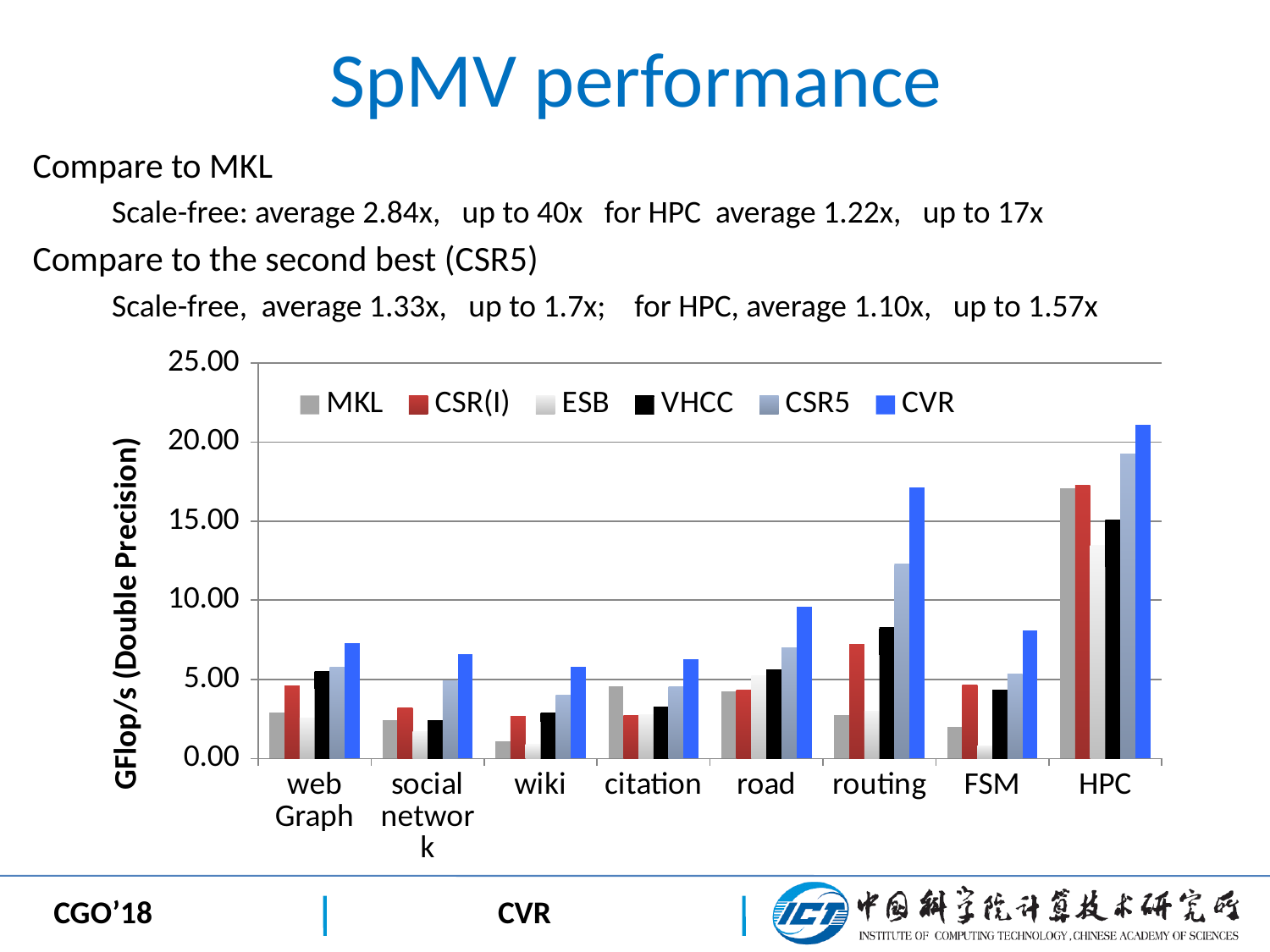
Is the CSR5 value for routing greater or less than 10.00? greater How many series does the legend list? 6 Is the CVR value for routing greater or less than 15.00? greater What kind of chart is shown on the slide? bar chart Is the CVR value for HPC greater or less than 20.00? greater What is the y-axis title of the chart? GFlop/s (Double Precision) Which category has the highest CVR value? HPC How many categories are shown on the x axis? 8 Which is larger for routing, the CSR5 value or the VHCC value? CSR5 Which series has the highest value for routing? CVR